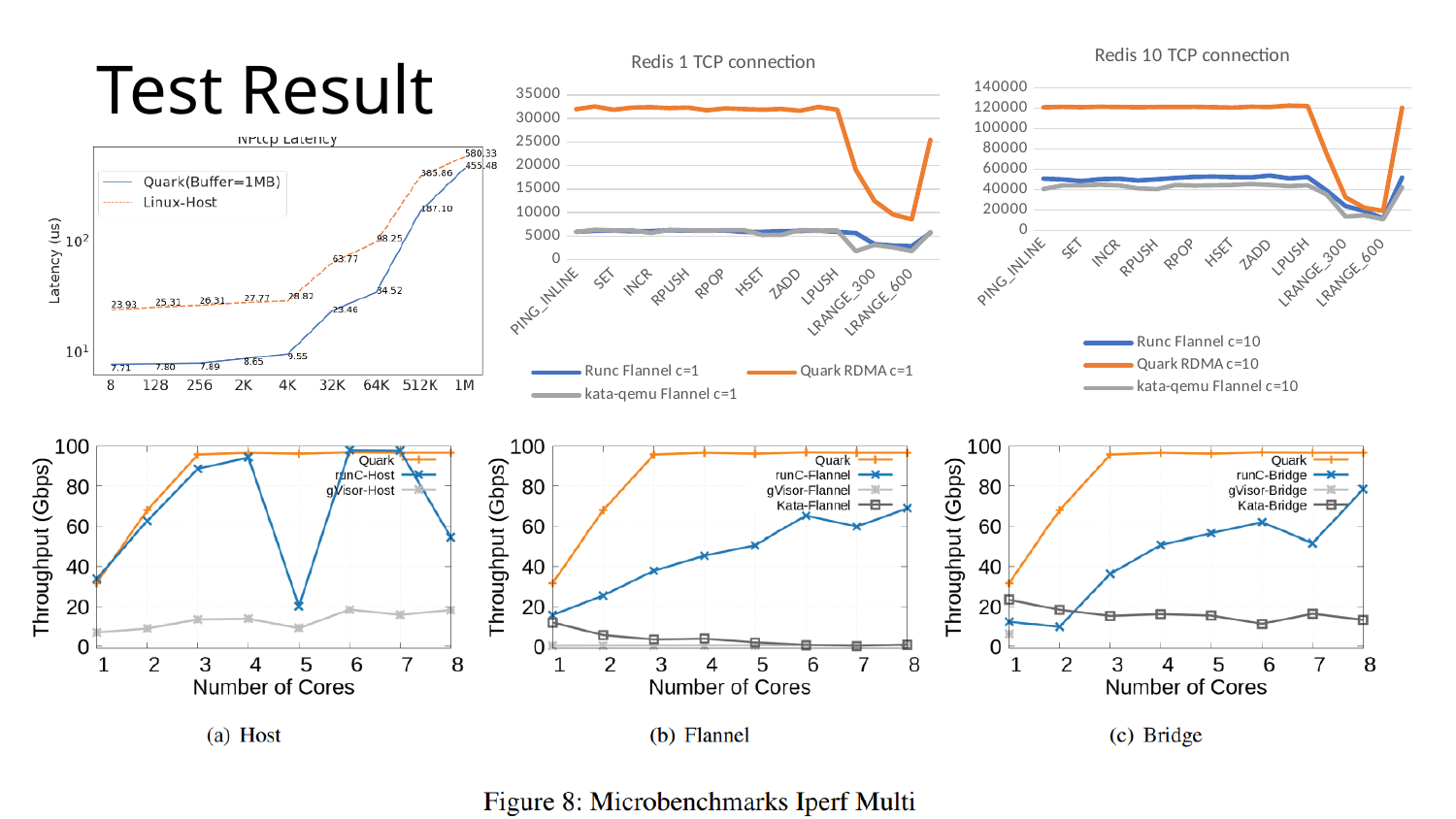
In the Redis 10 TCP connection chart, is the value for Runc Flannel c=10 at PING_INLINE greater or less than 40000? greater In the Redis 1 TCP connection chart, is the value for Quark RDMA c=1 at SET greater or less than 30000? greater In the (b) Flannel chart, does the Kata-Flannel throughput rise or fall as the number of cores increases? fall In the Redis 1 TCP connection chart, how many series does the legend list? 3 In the NPtcp Latency chart, what is the difference between the Linux-Host and Quark latencies at 1M? 124.85 In the NPtcp Latency chart, what is the latency for Quark(Buffer=1MB) at 512K? 187.10 What kind of chart is the (a) Host chart? line chart In the (a) Host chart, is the throughput for runC-Host at 5 cores greater or less than 40? less In the (b) Flannel chart, how many series does the legend list? 4 In the NPtcp Latency chart, how many series does the legend list? 2 In the NPtcp Latency chart, what is the latency for Linux-Host at 1M? 580.33